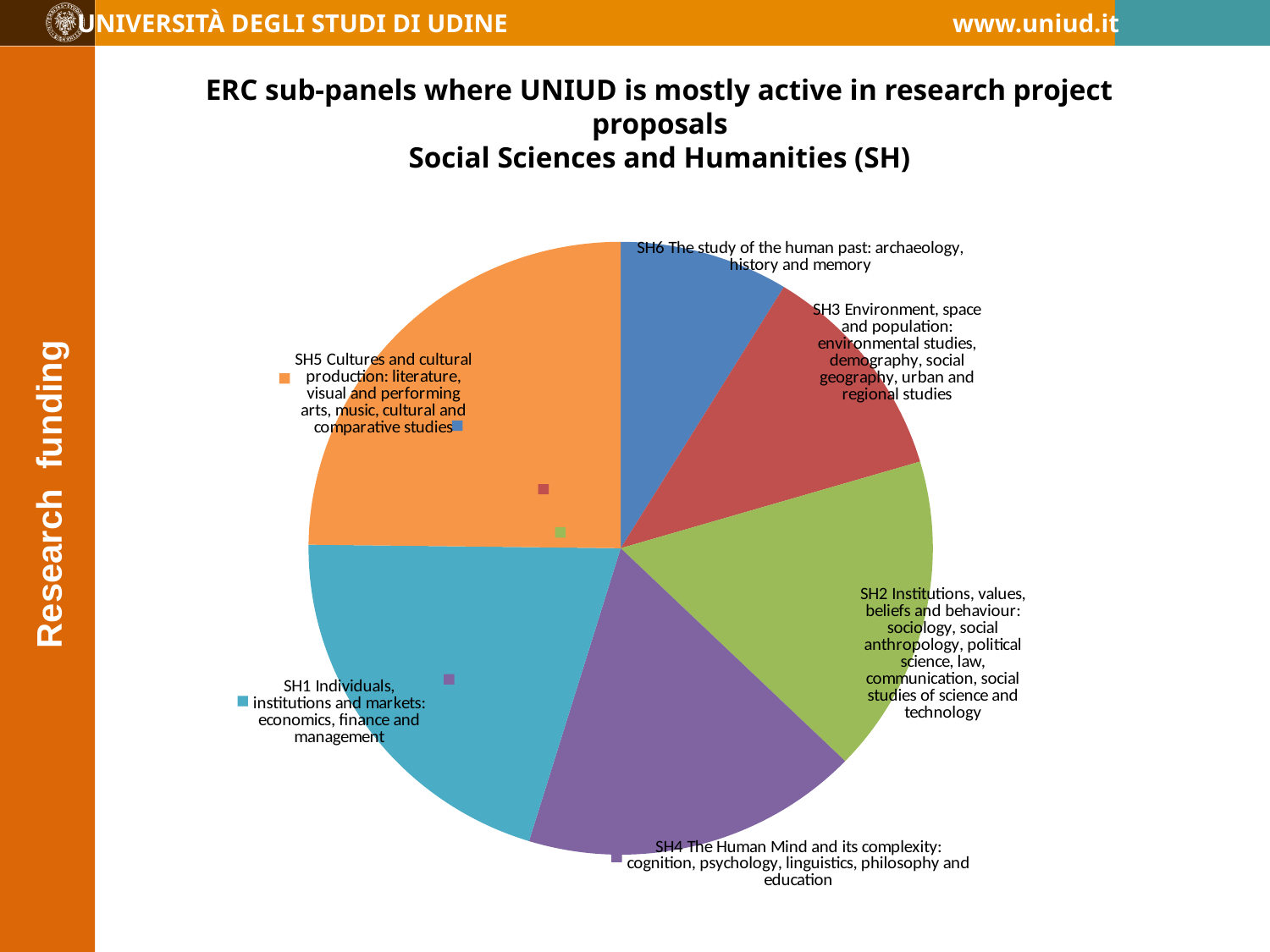
What kind of chart is shown on the slide? pie chart What is the title of the chart on the slide? ERC sub-panels where UNIUD is mostly active in research project proposals Social Sciences and Humanities (SH) What colour is the slice for SH5 Cultures and cultural production? orange How many slices does the pie chart have? 6 Which slice is larger, SH3 Environment, space and population or SH6 The study of the human past? SH3 Environment, space and population Which ERC sub-panel has the smallest slice of the pie chart? SH6 The study of the human past Which ERC sub-panel has the largest slice of the pie chart? SH5 Cultures and cultural production Which slice is larger, SH2 Institutions, values, beliefs and behaviour or SH6 The study of the human past? SH2 Institutions, values, beliefs and behaviour Which slice is larger, SH1 Individuals, institutions and markets or SH5 Cultures and cultural production? SH5 Cultures and cultural production